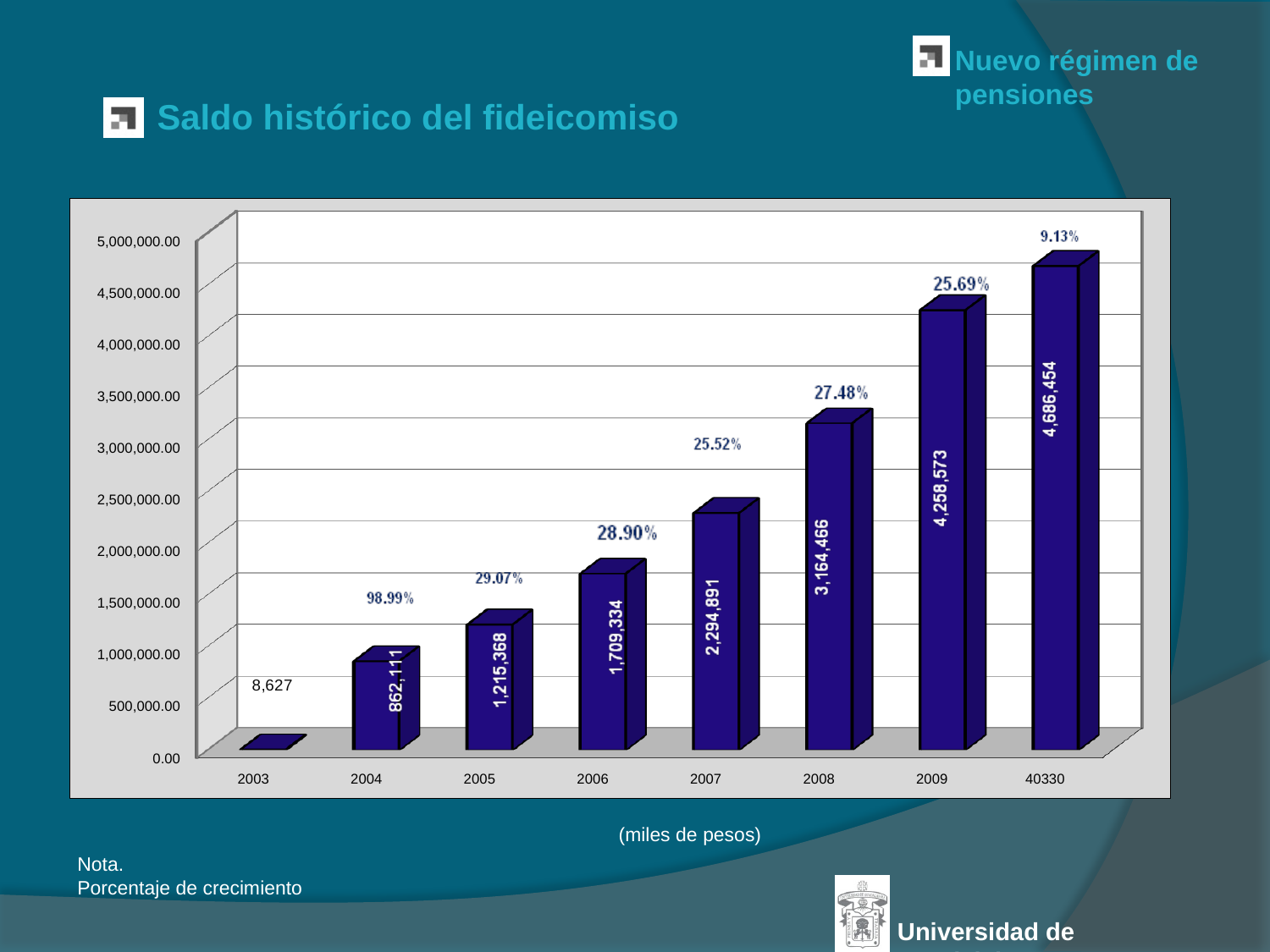
What kind of chart is shown on the slide? bar chart Which category has the highest value in the chart? 40330 What is the value for 2005 in the chart? 1,215,368 How many bars are plotted in the chart? 8 What growth percentage is shown above the 2004 bar? 98.99% What is the value for 2008 in the chart? 3,164,466 Do the bar values rise or fall from 2003 to 2009? rise Which is larger, the value for 2006 or the value for 2007? 2007 What is the value for 2003 in the chart? 8,627 What is the difference between the values for 2009 and 2008? 1,094,107 What growth percentage is shown above the 2009 bar? 25.69% Which year has the lowest value in the chart? 2003